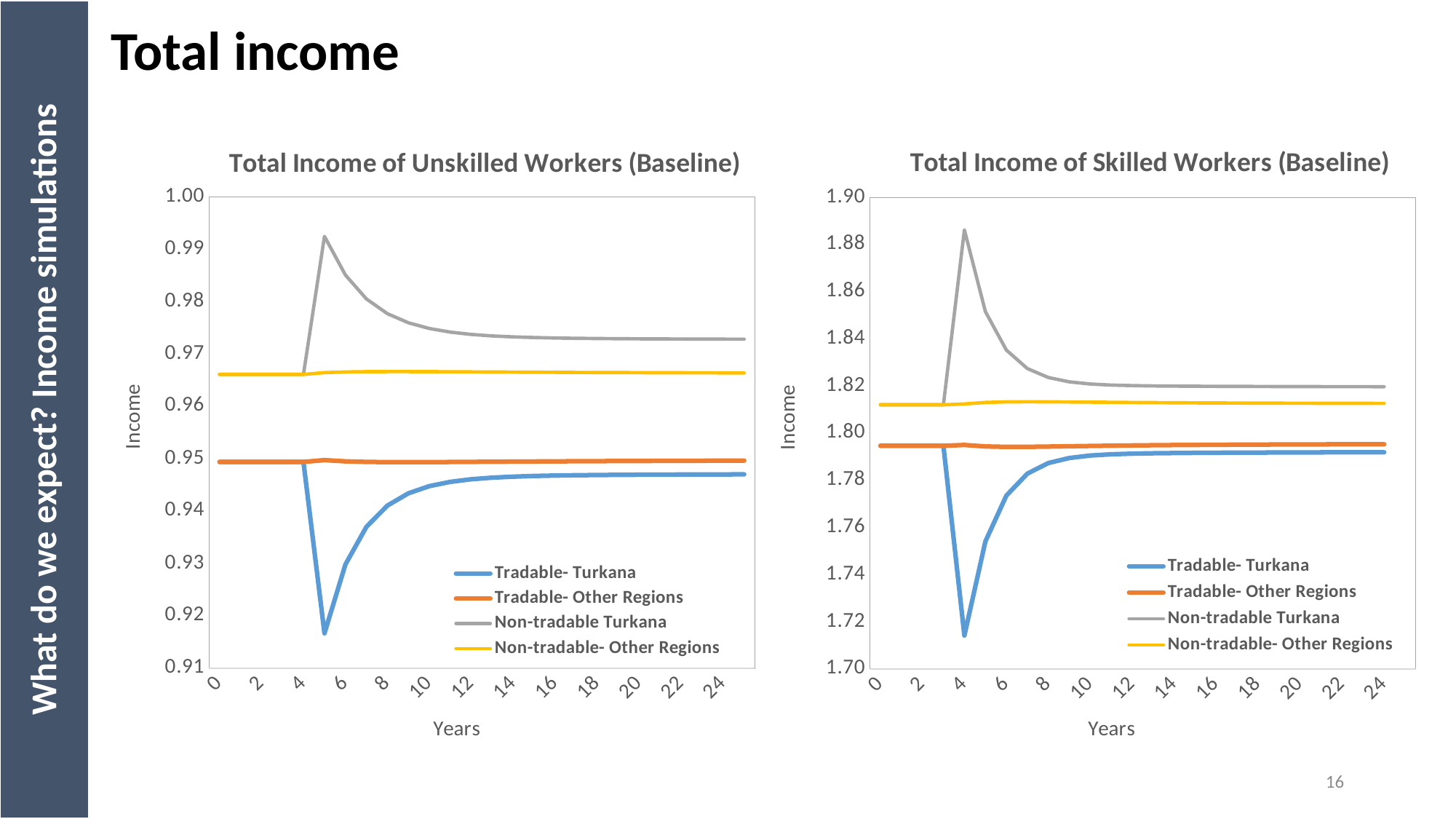
In the "Total Income of Skilled Workers (Baseline)" chart, at year 6, which is higher: Tradable- Turkana or Tradable- Other Regions? Tradable- Other Regions In the "Total Income of Unskilled Workers (Baseline)" chart, which series reaches the lowest value? Tradable- Turkana In the "Total Income of Unskilled Workers (Baseline)" chart, is the lowest value of Tradable- Turkana greater or less than 0.92? less In the "Total Income of Unskilled Workers (Baseline)" chart, is the peak value of Non-tradable Turkana greater or less than 0.98? greater In the "Total Income of Skilled Workers (Baseline)" chart, is the lowest value of Tradable- Turkana greater or less than 1.74? less In the "Total Income of Unskilled Workers (Baseline)" chart, which series reaches the highest value? Non-tradable Turkana In the "Total Income of Skilled Workers (Baseline)" chart, does the Non-tradable Turkana series rise or fall between year 4 and year 10? fall What kind of chart is the "Total Income of Unskilled Workers (Baseline)" chart? line chart How many series does the legend of the "Total Income of Skilled Workers (Baseline)" chart list? 4 In the "Total Income of Unskilled Workers (Baseline)" chart, at year 24, which is higher: Non-tradable Turkana or Non-tradable- Other Regions? Non-tradable Turkana What is the label of the vertical axis on the "Total Income of Skilled Workers (Baseline)" chart? Income